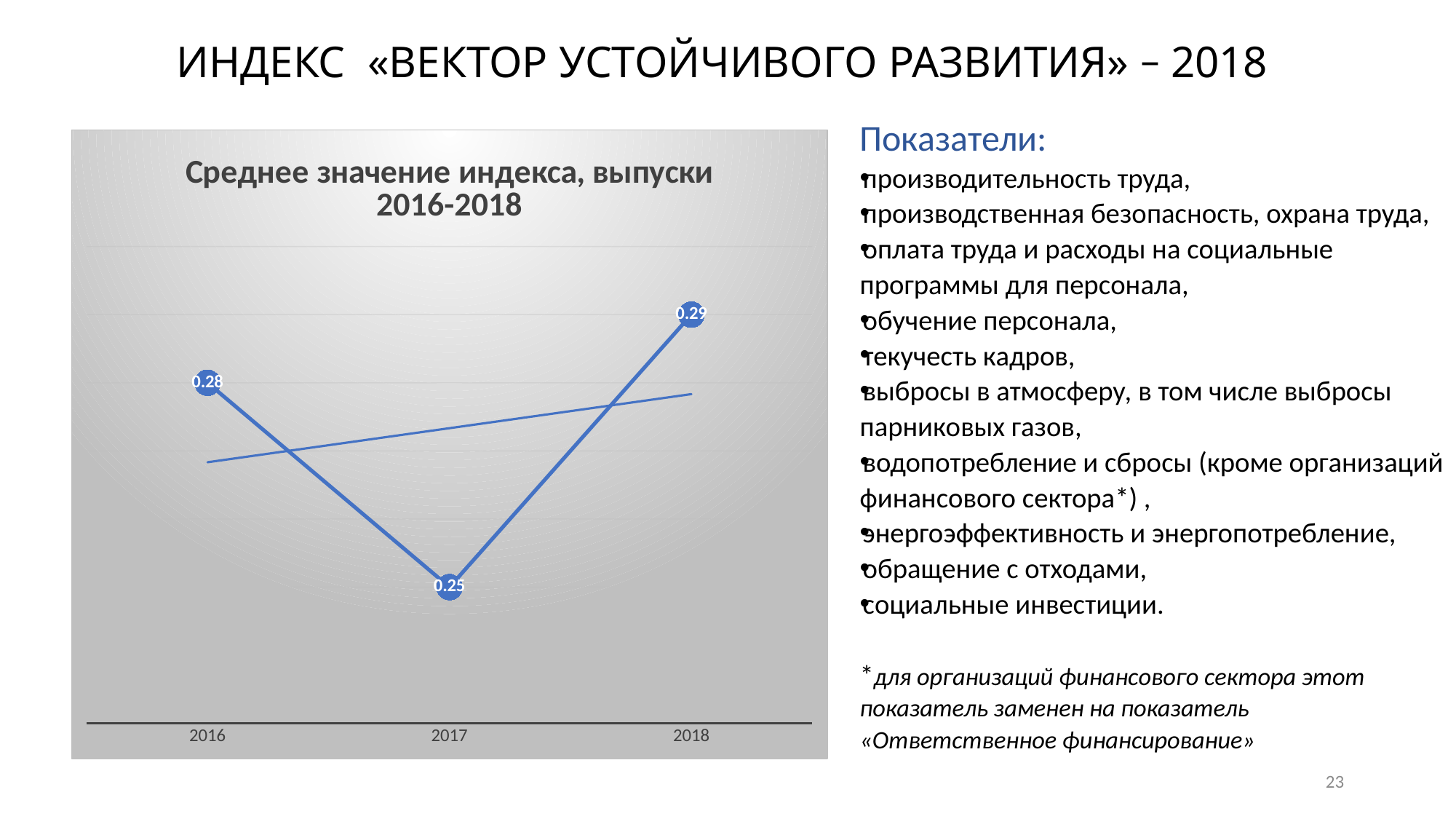
Does the index value rise or fall from 2017 to 2018? rise Which year has the lowest average index value? 2017 How many years are plotted on the chart? 3 What is the average index value for 2017? 0.25 Which is larger, the index value for 2016 or for 2018? 2018 What is the difference between the index values for 2016 and 2017? 0.03 What kind of chart is shown on the slide? line chart What is the average index value for 2016? 0.28 What is the average index value for 2018? 0.29 What is the title of the chart? Среднее значение индекса, выпуски 2016-2018 What is the difference between the index values for 2018 and 2017? 0.04 Which year has the highest average index value? 2018